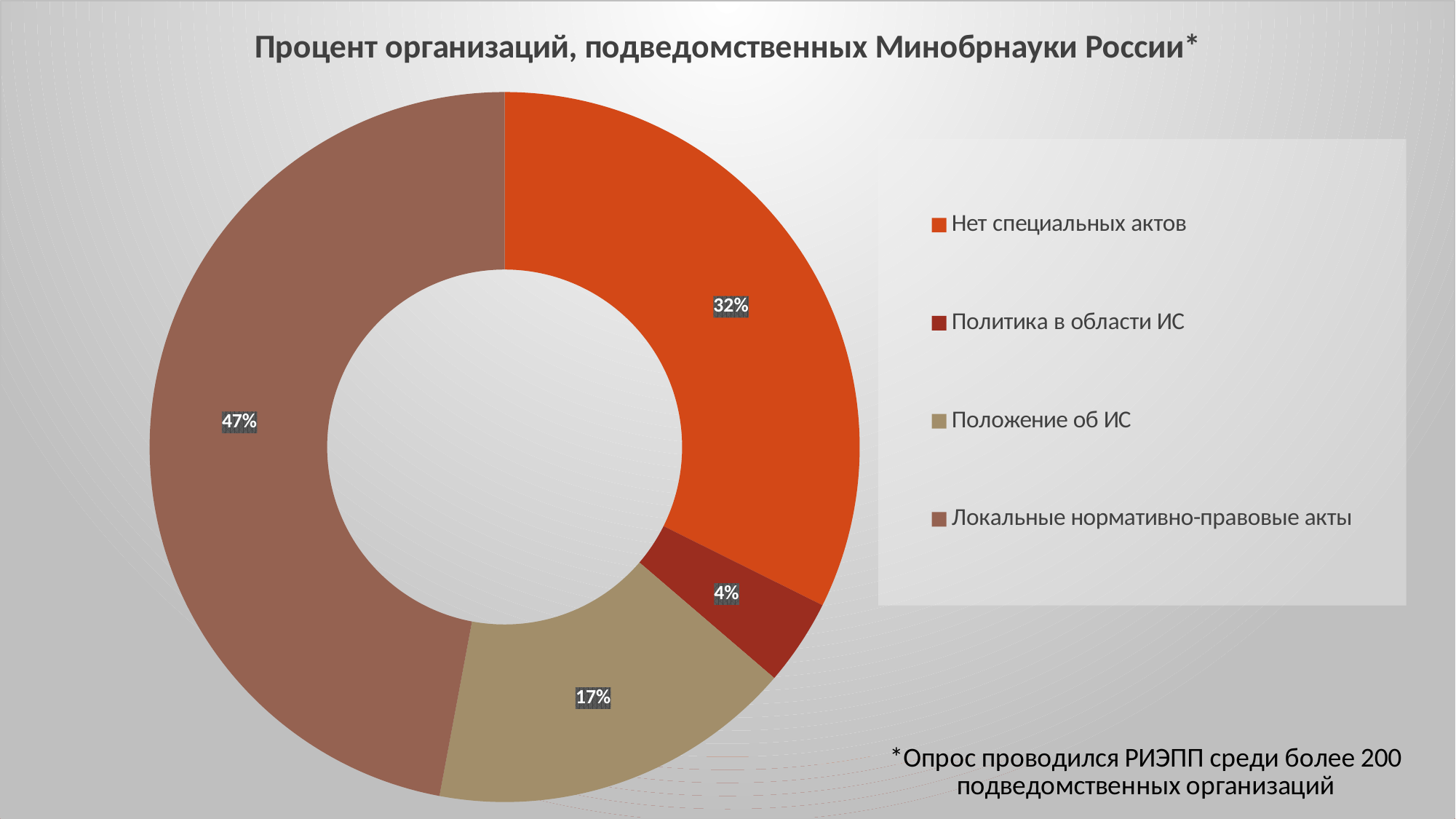
Which is larger: the share for «Положение об ИС» or the share for «Политика в области ИС»? Положение об ИС What is the title of the chart? Процент организаций, подведомственных Минобрнауки России* Which category has the smallest share of the chart? Политика в области ИС What percentage is shown for «Положение об ИС»? 17% What is the difference in percentage points between «Локальные нормативно-правовые акты» and «Нет специальных актов»? 15 What percentage is shown for «Политика в области ИС»? 4% What percentage is shown for «Локальные нормативно-правовые акты»? 47% Which category has the largest share of the chart? Локальные нормативно-правовые акты What colour is the slice for «Нет специальных актов»? Orange How many categories does the chart show? 4 What kind of chart is shown on the slide? Doughnut (pie) chart What percentage is shown for «Нет специальных актов»? 32%